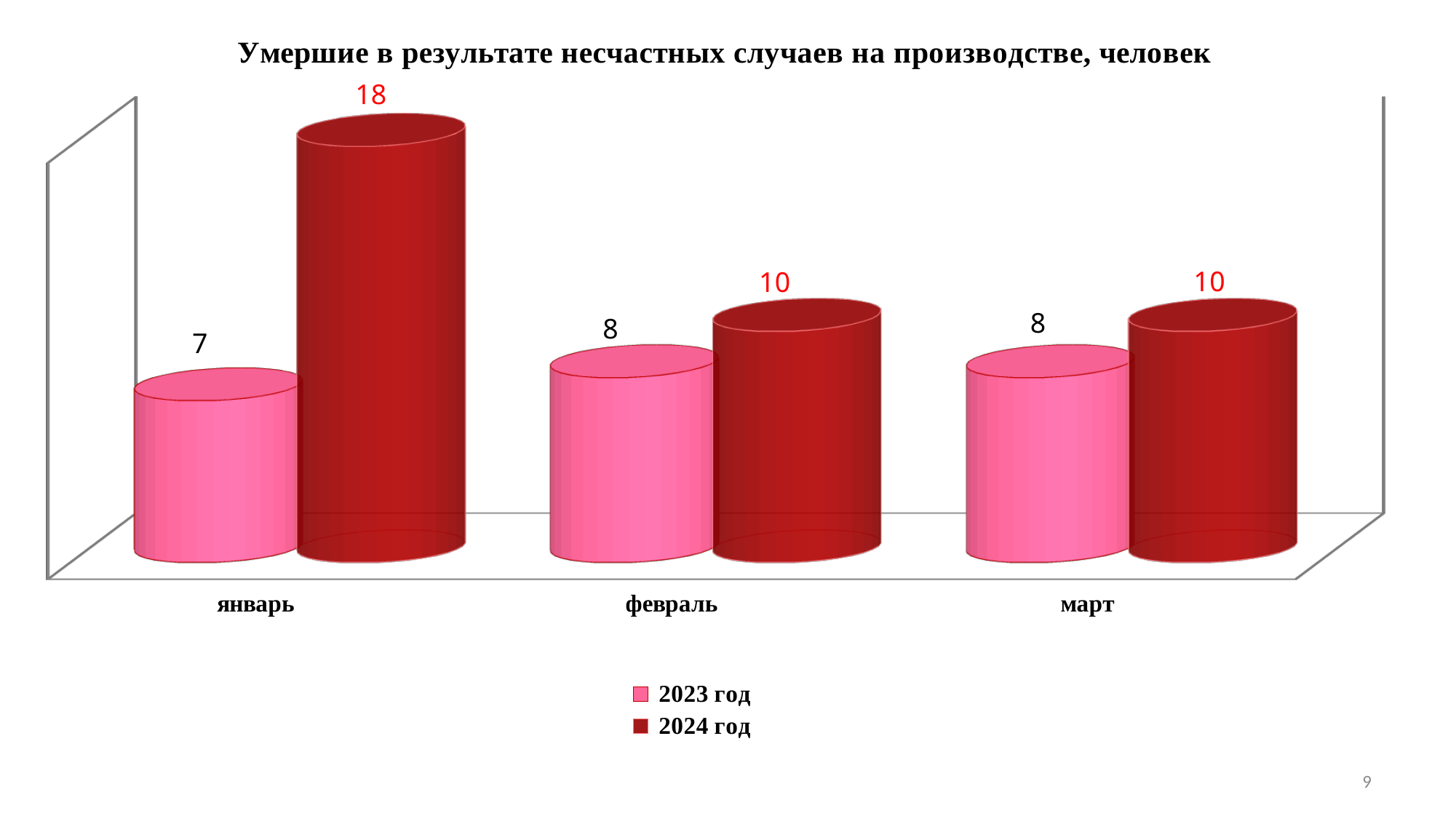
In which month is the 2023 год value lowest? январь In which month is the 2024 год value highest? январь Which is larger in март: the 2023 год value or the 2024 год value? 2024 год How many months are shown on the x axis? 3 What is the value for 2024 год in март? 10 What is the value for 2023 год in февраль? 8 What kind of chart is shown on the slide? bar chart What is the value for 2024 год in январь? 18 What is the value for 2023 год in январь? 7 What is the difference between the 2024 год and 2023 год values in январь? 11 What is the difference between the 2024 год and 2023 год values in февраль? 2 How many series does the legend list? 2